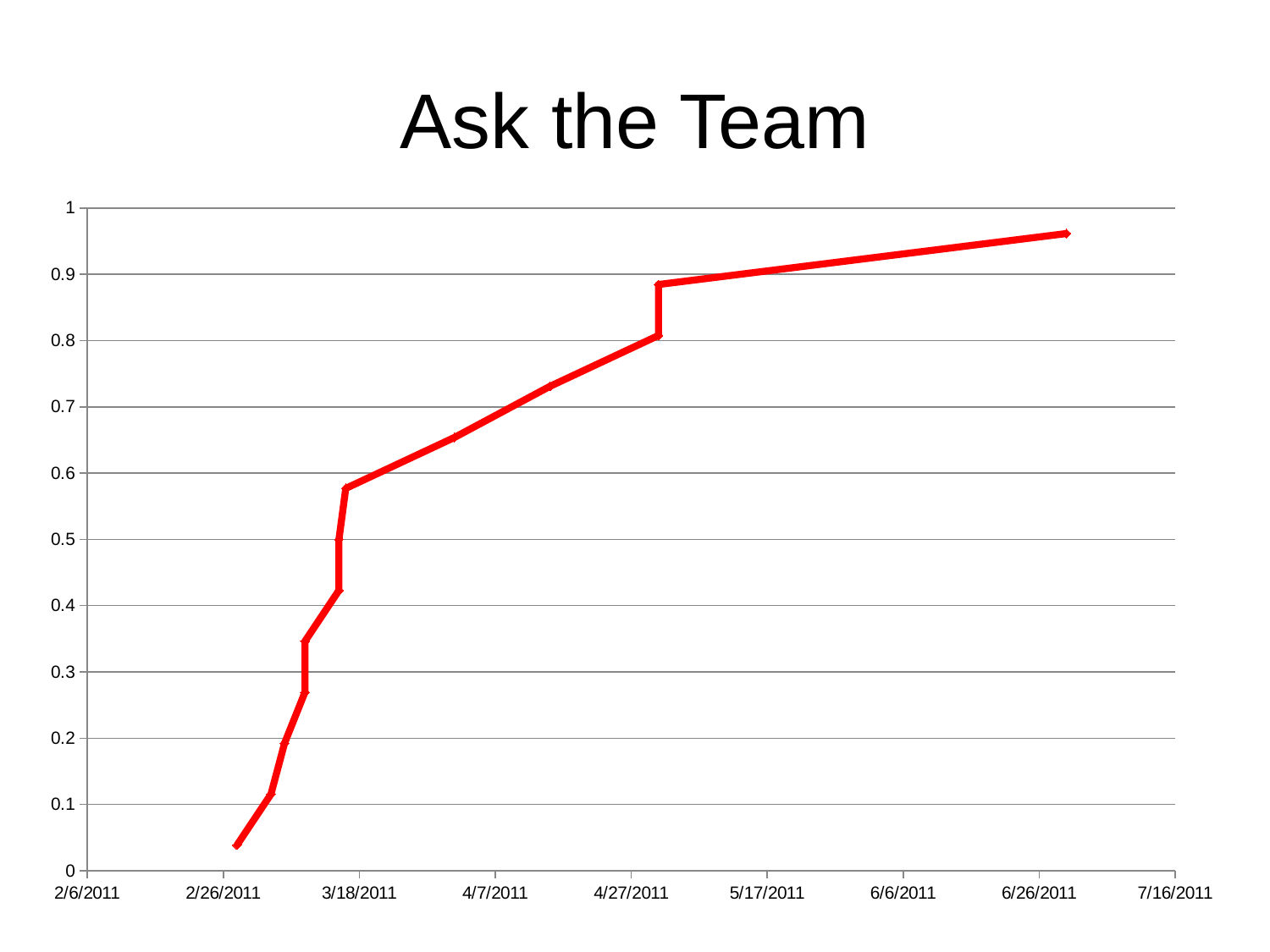
Is the lowest value on the line greater or less than 0.1? less Is the value of the last (rightmost) point greater or less than 0.9? greater Is the highest value on the line greater or less than 0.9? greater Do the values rise or fall as the dates move from left to right along the x axis? rise What kind of chart is shown on the slide? line chart What colour is the plotted line? red What is the title of the chart? Ask the Team Which is larger, the value at the rightmost point or the value at the leftmost point? the rightmost point How many lines (series) are plotted on the chart? 1